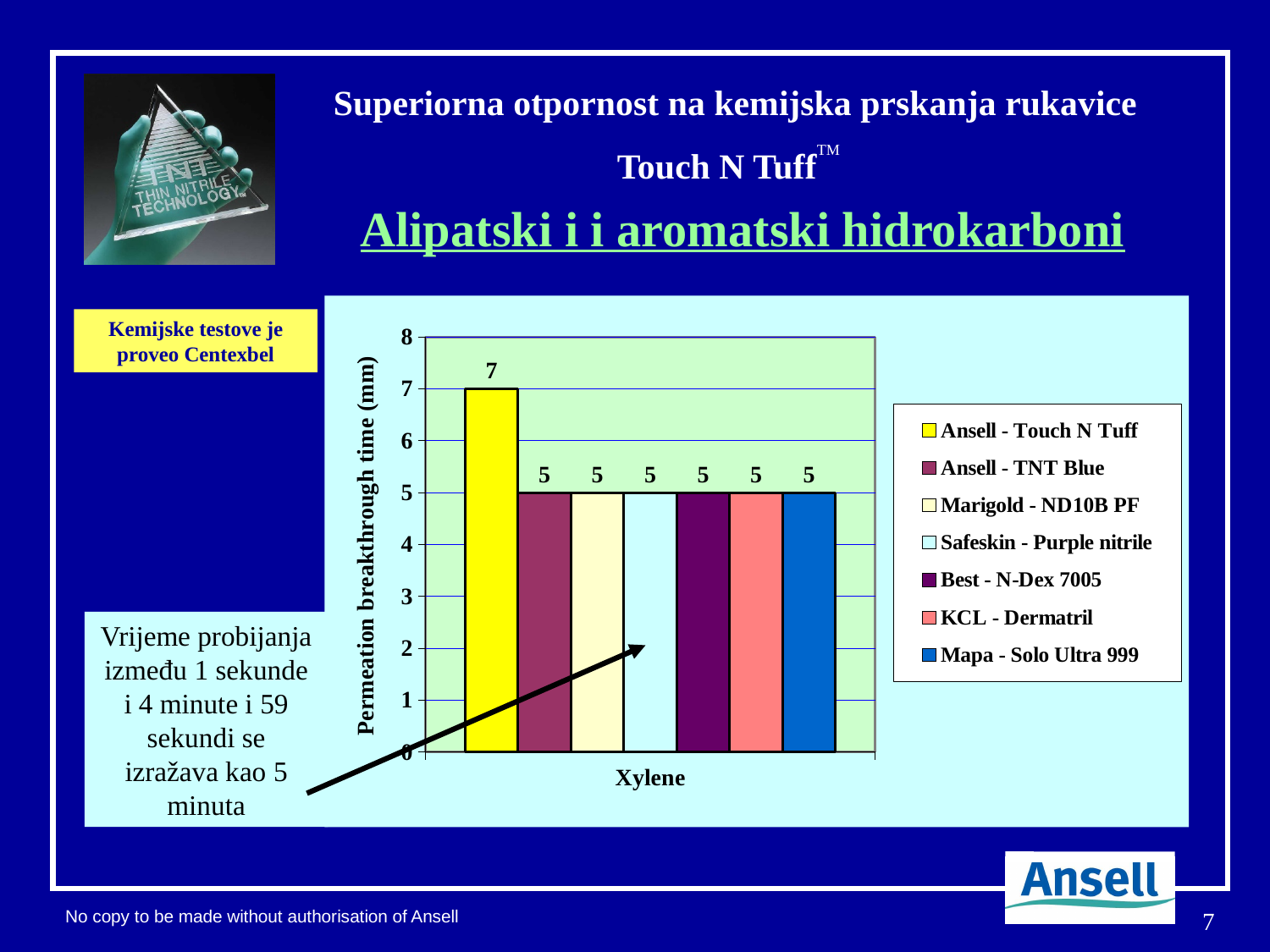
How many series have a value of 5? 6 What is the label on the x axis of the chart? Xylene What is the permeation breakthrough time for Ansell - Touch N Tuff in Xylene? 7 How many series does the legend list? 7 What is the value shown for Best - N-Dex 7005? 5 Which series has the highest permeation breakthrough time? Ansell - Touch N Tuff What is the label on the y axis of the chart? Permeation breakthrough time (mm) What is the difference between the value for Ansell - Touch N Tuff and the value for KCL - Dermatril? 2 Is the value for Ansell - Touch N Tuff greater or less than 6? greater Which is larger, the value for Ansell - Touch N Tuff or the value for Safeskin - Purple nitrile? Ansell - Touch N Tuff What kind of chart is shown on the slide? bar chart What is the permeation breakthrough time for Mapa - Solo Ultra 999 in Xylene? 5